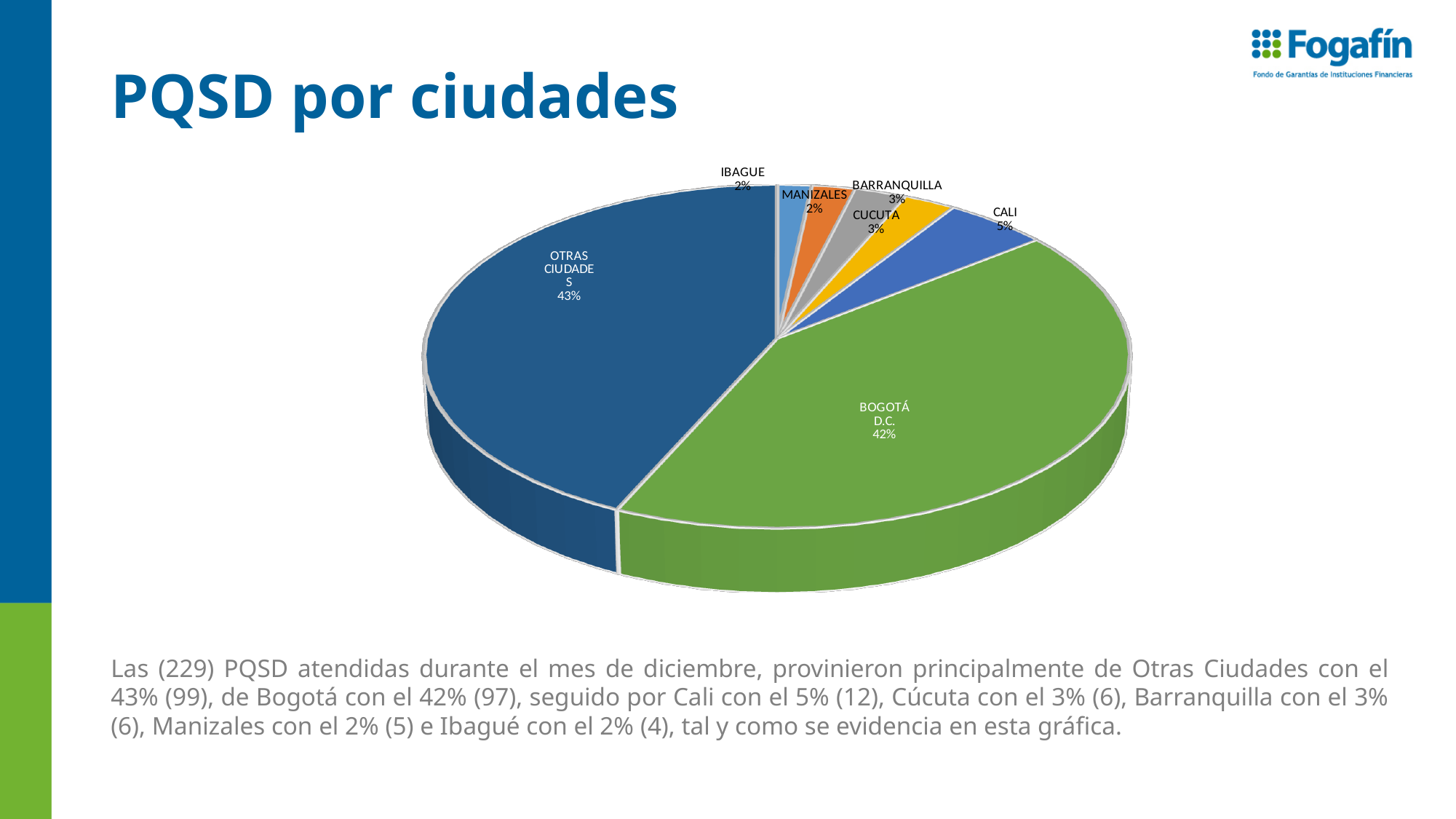
What share of the pie does BOGOTÁ D.C. represent? 42% What is the value shown for MANIZALES? 2% What is the value shown for CUCUTA? 3% How many slices does the pie chart have? 7 Which is larger, the slice for CALI or the slice for BARRANQUILLA? CALI What is the difference in percentage points between CALI and CUCUTA? 2% What is the title of the slide containing the pie chart? PQSD por ciudades Which slice of the pie is the largest? OTRAS CIUDADES What is the value shown for CALI? 5% What share of the pie does OTRAS CIUDADES represent? 43% What kind of chart is shown on the slide? pie chart What is the difference in percentage points between OTRAS CIUDADES and BOGOTÁ D.C.? 1%